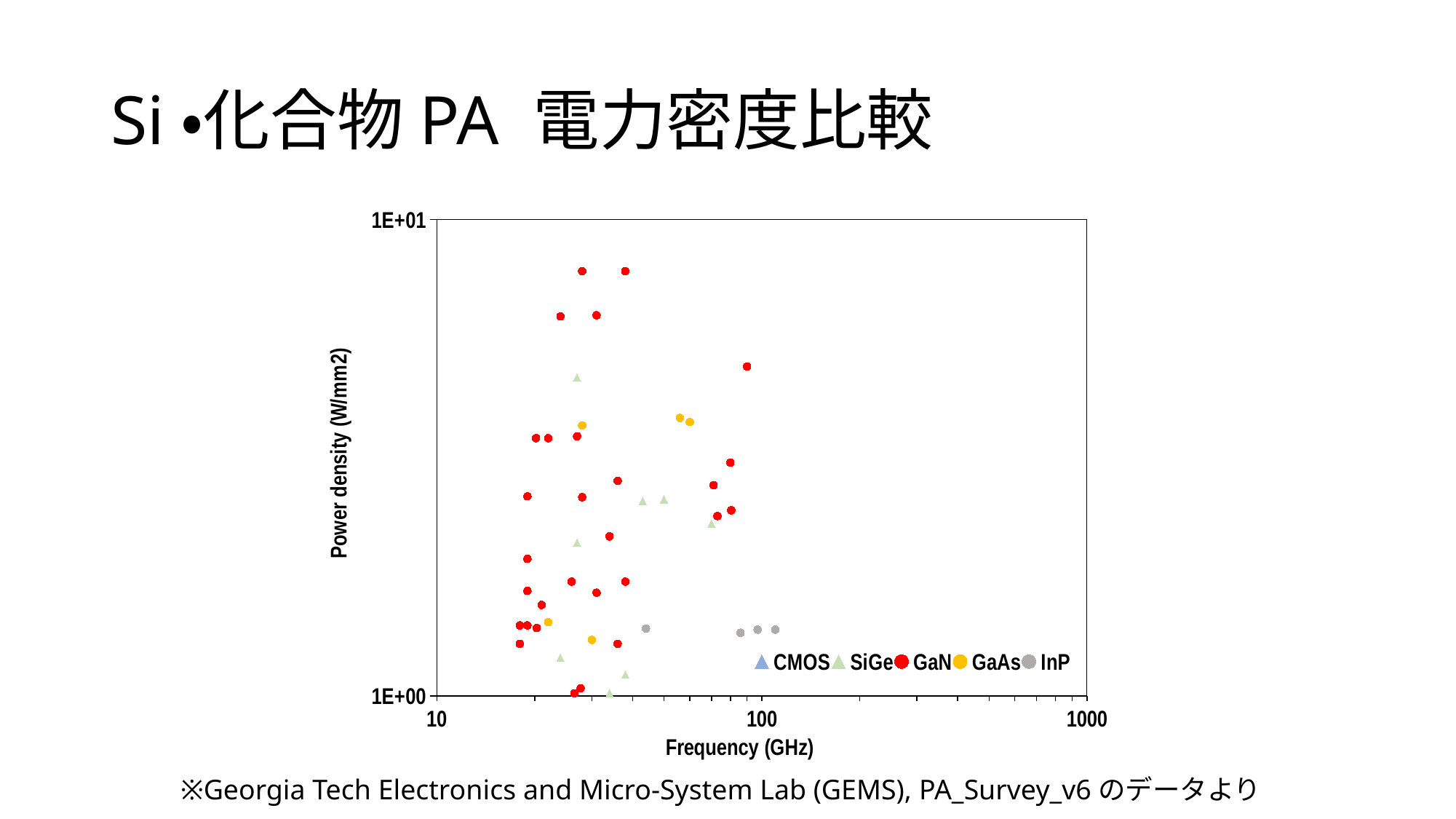
Is the frequency of the InP points greater or less than 10 GHz? greater What are the series names listed in the chart legend? CMOS, SiGe, GaN, GaAs, InP Is the frequency of the highest-power-density GaN point greater or less than 100 GHz? less How many series does the chart legend list? 5 What kind of chart is shown on the slide? scatter chart Which series has a higher maximum power density, GaAs or InP? GaAs What is the label of the x axis? Frequency (GHz) Which series has the lowest-frequency points on the chart? GaN Which series has a higher maximum power density, GaN or InP? GaN Is the power density of the highest GaN point greater or less than 1E+01 W/mm2? less Which series reaches the highest power density on the chart? GaN Which series has the most plotted points on the chart? GaN